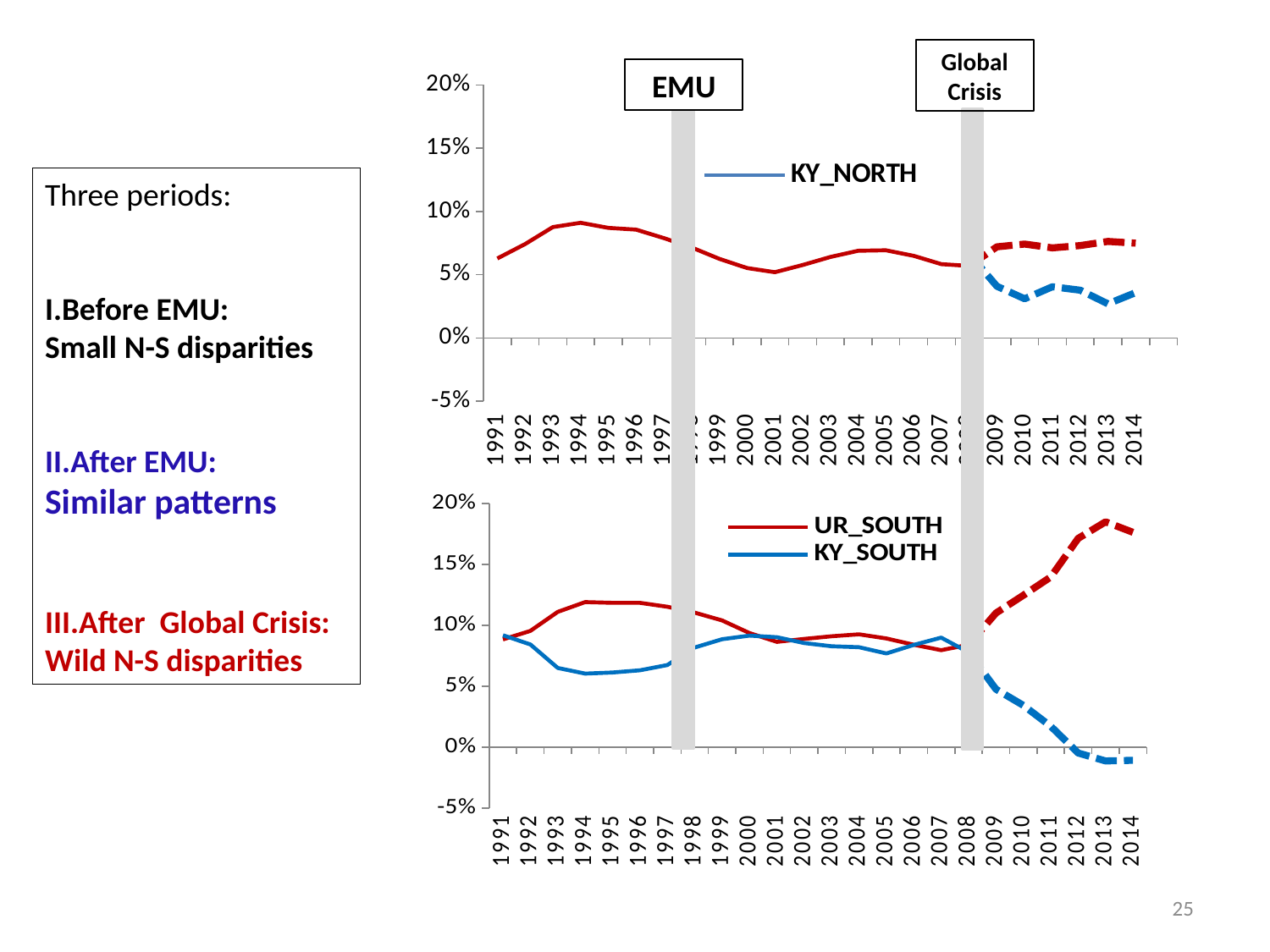
In the bottom chart, is the value of UR_SOUTH in 2013 greater or less than 15%? greater In the top chart, is the value of KY_NORTH in 2013 greater or less than 5%? less In the bottom chart, is the value of UR_SOUTH in 1994 greater or less than 10%? greater In the bottom chart, does UR_SOUTH rise or fall from 2009 to 2013? rise In the bottom chart, which series has the larger value in 2014, UR_SOUTH or KY_SOUTH? UR_SOUTH How many series does the legend of the top chart list? 1 In the bottom chart, does KY_SOUTH rise or fall from 2009 to 2014? fall What two events do the grey vertical bars on the charts mark? EMU and Global Crisis How many series does the legend of the bottom chart list? 2 What type of chart is the bottom chart (UR_SOUTH / KY_SOUTH)? line chart What is the first year and the last year shown on the x axis of the bottom chart? 1991 and 2014